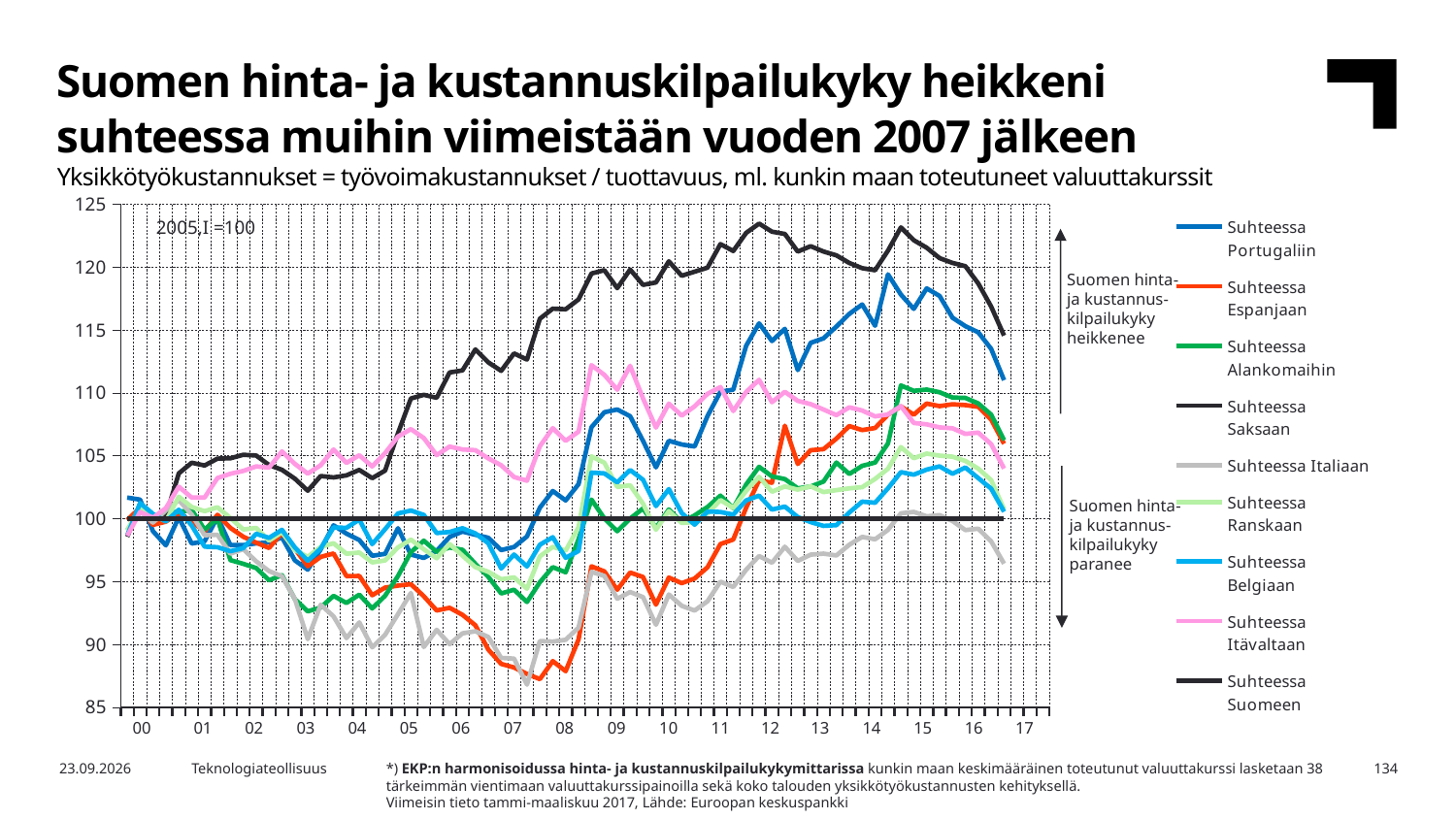
How many year labels are shown on the x axis? 18 Which series has the lowest value at the end of the chart in 2017? Suhteessa Italiaan What kind of chart is shown on the slide? line chart What base period is the index set to 100, as noted in the chart? 2005,I=100 At what value does the 'Suhteessa Suomeen' line stay throughout the chart? 100 Around 2014, which is larger: 'Suhteessa Saksaan' or 'Suhteessa Belgiaan'? Suhteessa Saksaan Does the 'Suhteessa Saksaan' line rise or fall between 2012 and 2017? fall How many series does the legend list? 9 Is the value of 'Suhteessa Portugaliin' around 2014 greater or less than 115? greater Is the value of 'Suhteessa Saksaan' around 2012 greater or less than 120? greater Is the value of 'Suhteessa Italiaan' around 2007 greater or less than 90? less Which series has the highest value around 2012? Suhteessa Saksaan